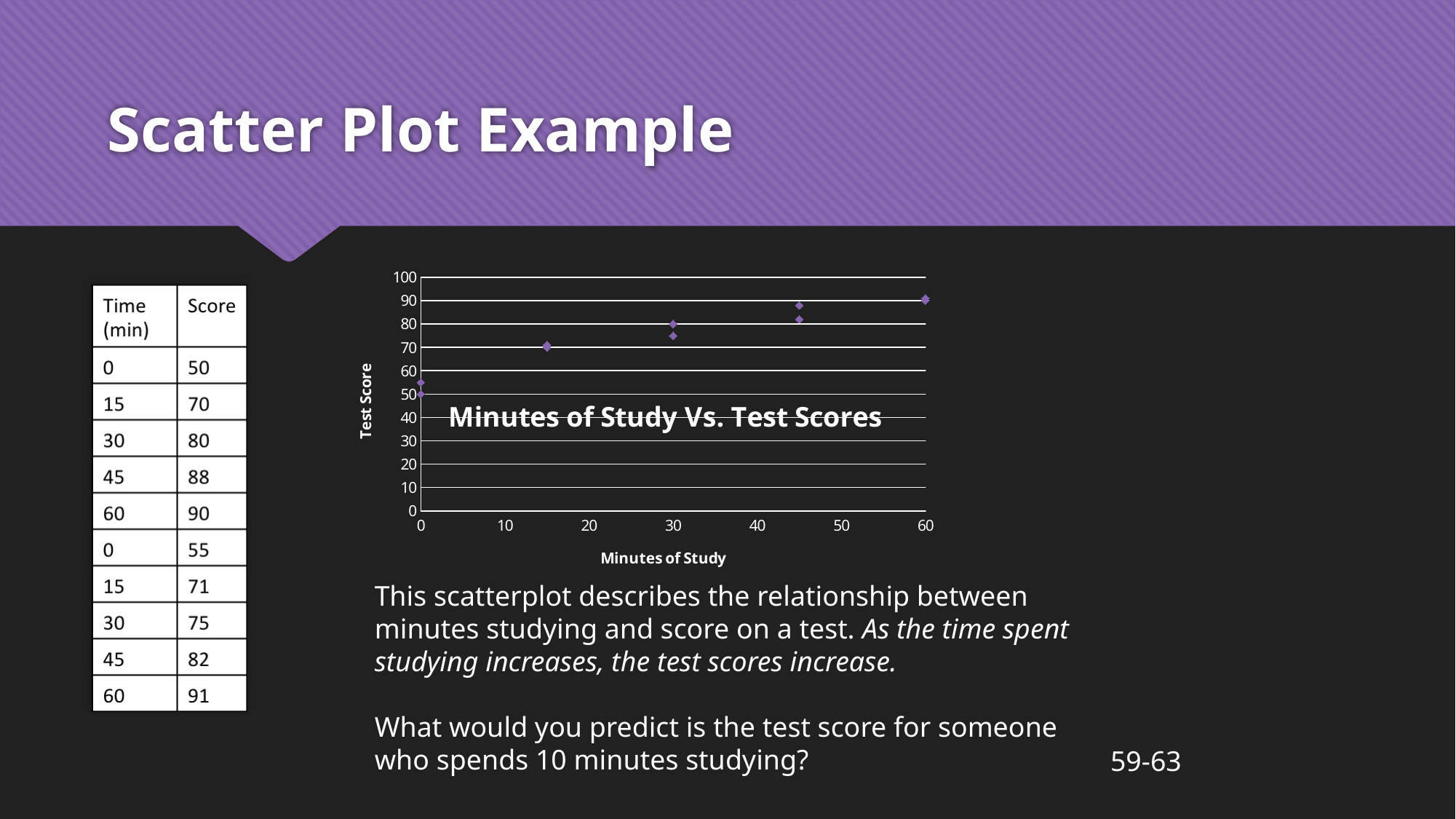
What is the difference between the two test scores plotted at 30 minutes of study? 5 What is the title of the chart? Minutes of Study Vs. Test Scores What is the label of the vertical axis of the chart? Test Score Is the test score for the point at 60 minutes of study greater or less than 80? greater What is the highest test score plotted on the chart? 91 What is the lowest test score plotted on the chart? 50 What kind of chart is shown on the slide? scatter plot What are the two test scores plotted at 45 minutes of study? 88 and 82 What are the two test scores plotted at 15 minutes of study? 70 and 71 Which has a higher test score: the point at 15 minutes with score 70 or the point at 30 minutes with score 80? the point at 30 minutes How many data points are plotted on the scatter plot? 10 Do test scores rise or fall as minutes of study increase along the x axis? rise